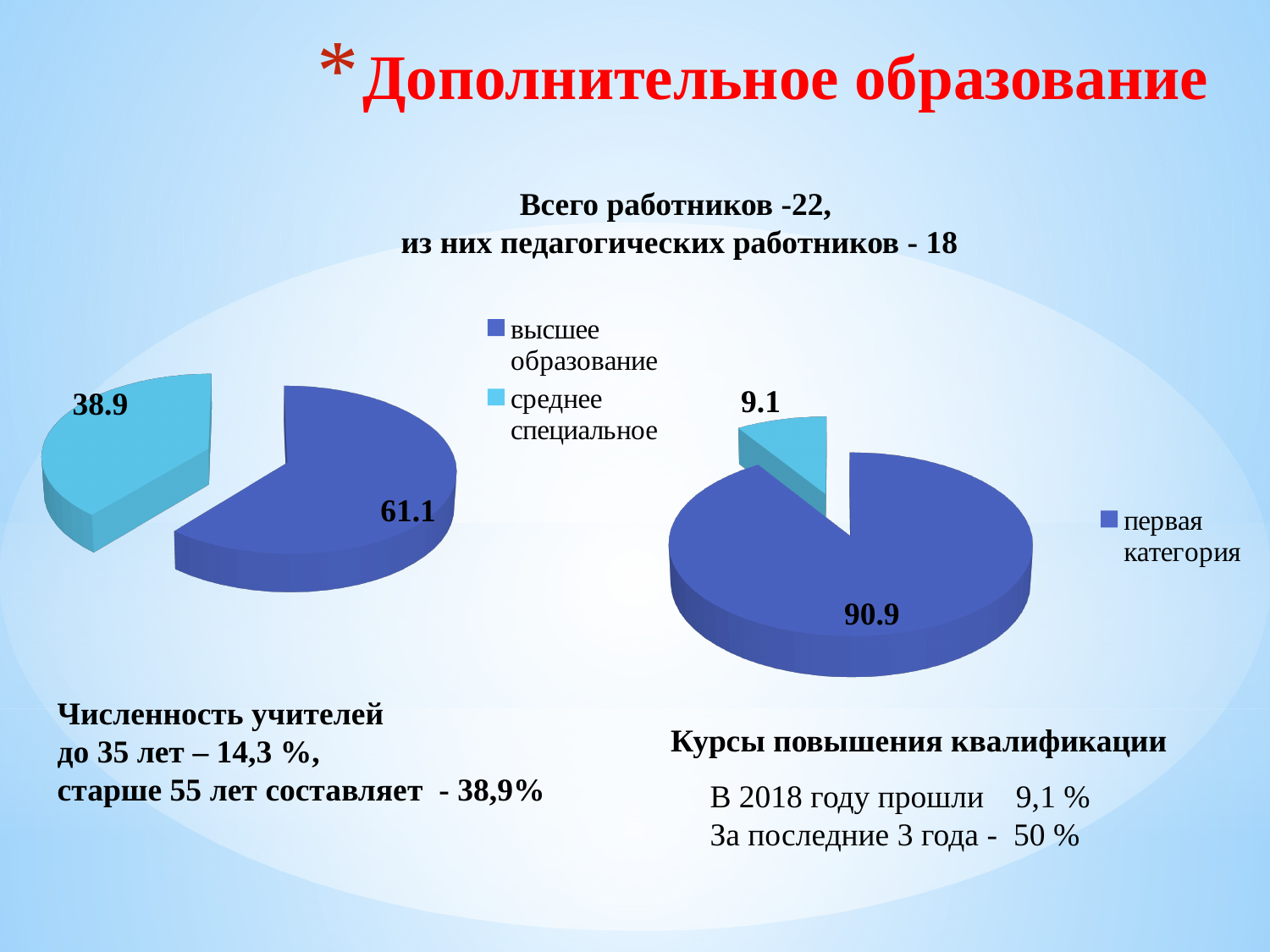
How many entries does the legend of the right pie chart list? 1 In the right pie chart, what value is labelled on the small light blue slice? 9.1 What kind of chart is the left chart on the slide? pie chart In the right pie chart, what is the value for первая категория? 90.9 In the left pie chart, what is the value for среднее специальное? 38.9 In the left pie chart, what colour is the slice for высшее образование? dark blue How many slices does the right pie chart have? 2 In the left pie chart, what is the value for высшее образование? 61.1 In the left pie chart, which category has the largest slice? высшее образование How many entries does the legend of the left pie chart list? 2 In the left pie chart, which is larger: высшее образование or среднее специальное? высшее образование In the left pie chart, what is the difference between the values for высшее образование and среднее специальное? 22.2